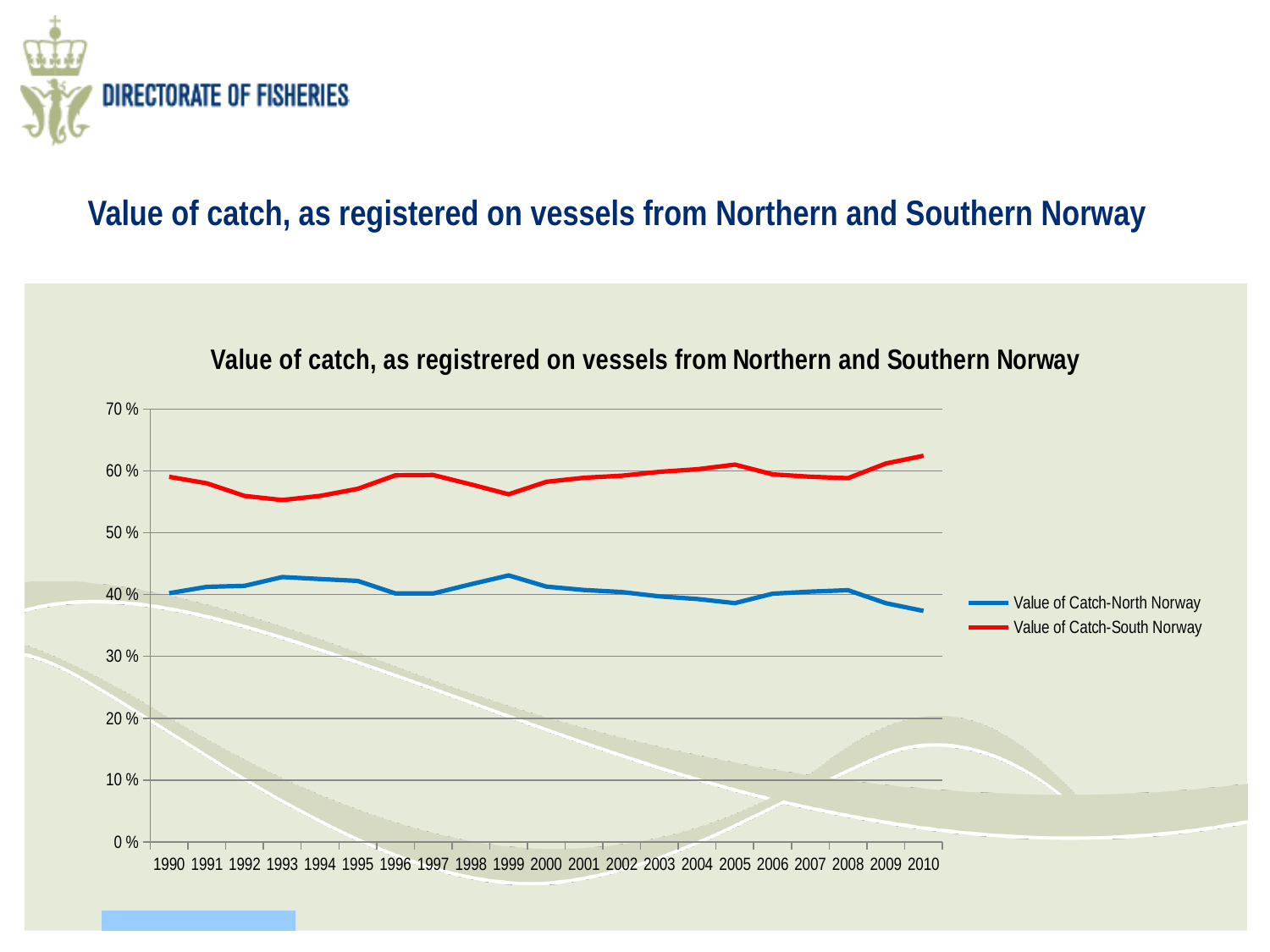
How many series does the legend list? 2 Is the value for Value of Catch-South Norway in 2010 greater or less than 60 %? greater Is the value for Value of Catch-North Norway in 1999 greater or less than 40 %? greater In which year is Value of Catch-South Norway at its highest? 2010 Does Value of Catch-North Norway rise or fall from 2008 to 2010? fall How many years are plotted along the x axis? 21 In 1990, which series has the larger value, Value of Catch-North Norway or Value of Catch-South Norway? Value of Catch-South Norway Which colour is used for the Value of Catch-South Norway line? red Is the value for Value of Catch-North Norway in 2010 greater or less than 40 %? less What kind of chart is shown on the slide? line chart In which year is Value of Catch-North Norway at its lowest? 2010